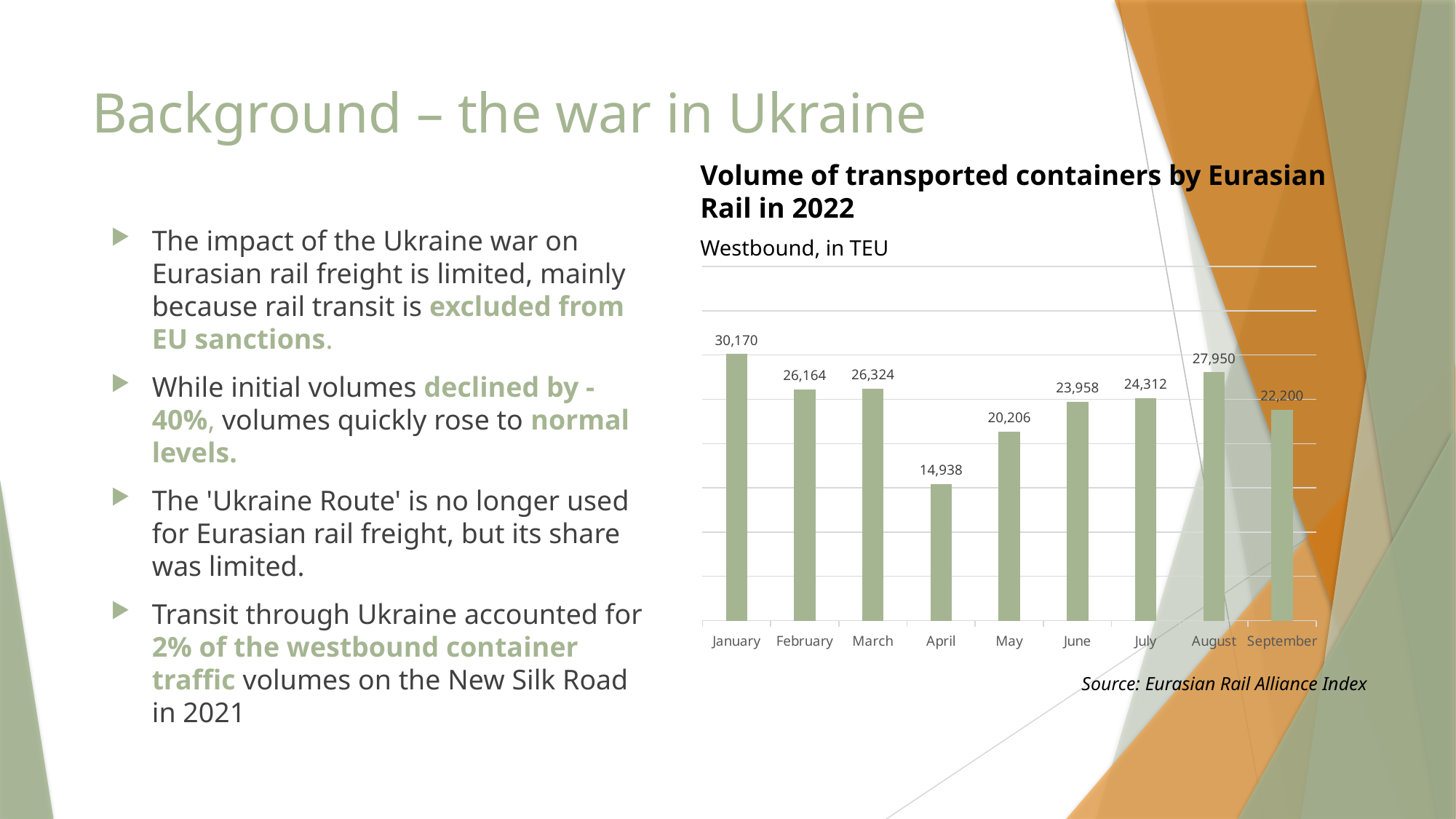
What is the volume of transported containers in April? 14,938 What is the difference between the January and April volumes? 15,232 Which month has a larger volume, June or July? July Which month has the highest volume of transported containers? January What is the volume of transported containers in August? 27,950 How many months are shown on the chart? 9 What unit is the chart's data measured in, according to the subtitle? TEU What is the volume of transported containers in September? 22,200 What is the volume of transported containers in January? 30,170 What kind of chart is shown on the slide? Bar chart Which month has the lowest volume of transported containers? April What is the difference between the August and September volumes? 5,750